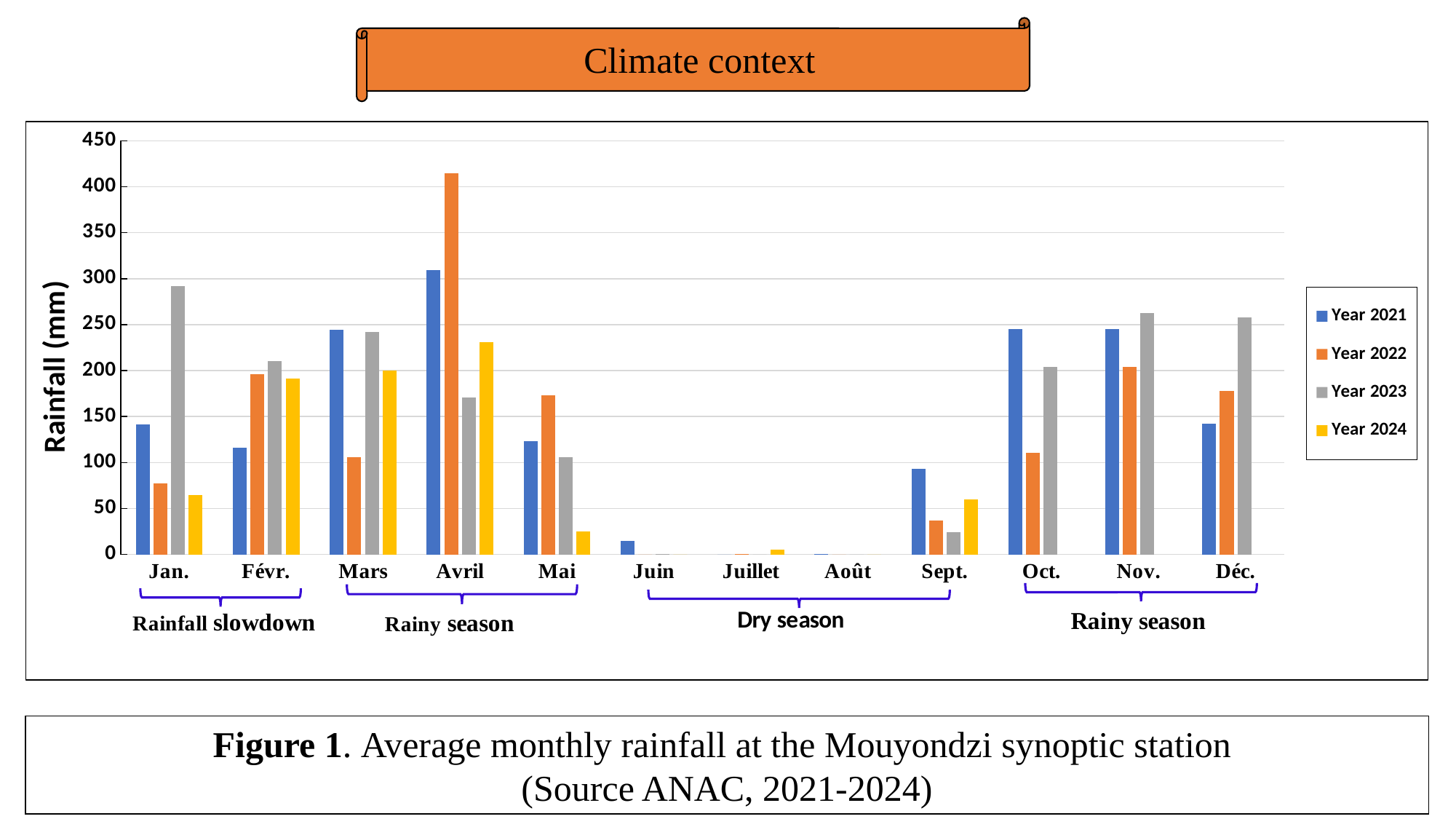
How many months are shown on the x axis? 12 What is the label of the y axis? Rainfall (mm) In which month is the Year 2022 rainfall highest? Avril How many series does the legend list? 4 In Jan., which is larger: the Year 2021 value or the Year 2022 value? Year 2021 What kind of chart is shown on the slide? Bar chart In which month is the Year 2023 rainfall highest? Jan. In Avril, which is larger: the Year 2021 value or the Year 2024 value? Year 2021 Is the Year 2021 value for Mars greater or less than 200? greater In Mai, which year has the lowest rainfall? Year 2024 Is the Year 2023 value for Jan. greater or less than 250? greater Is the Year 2022 value for Avril greater or less than 400? greater